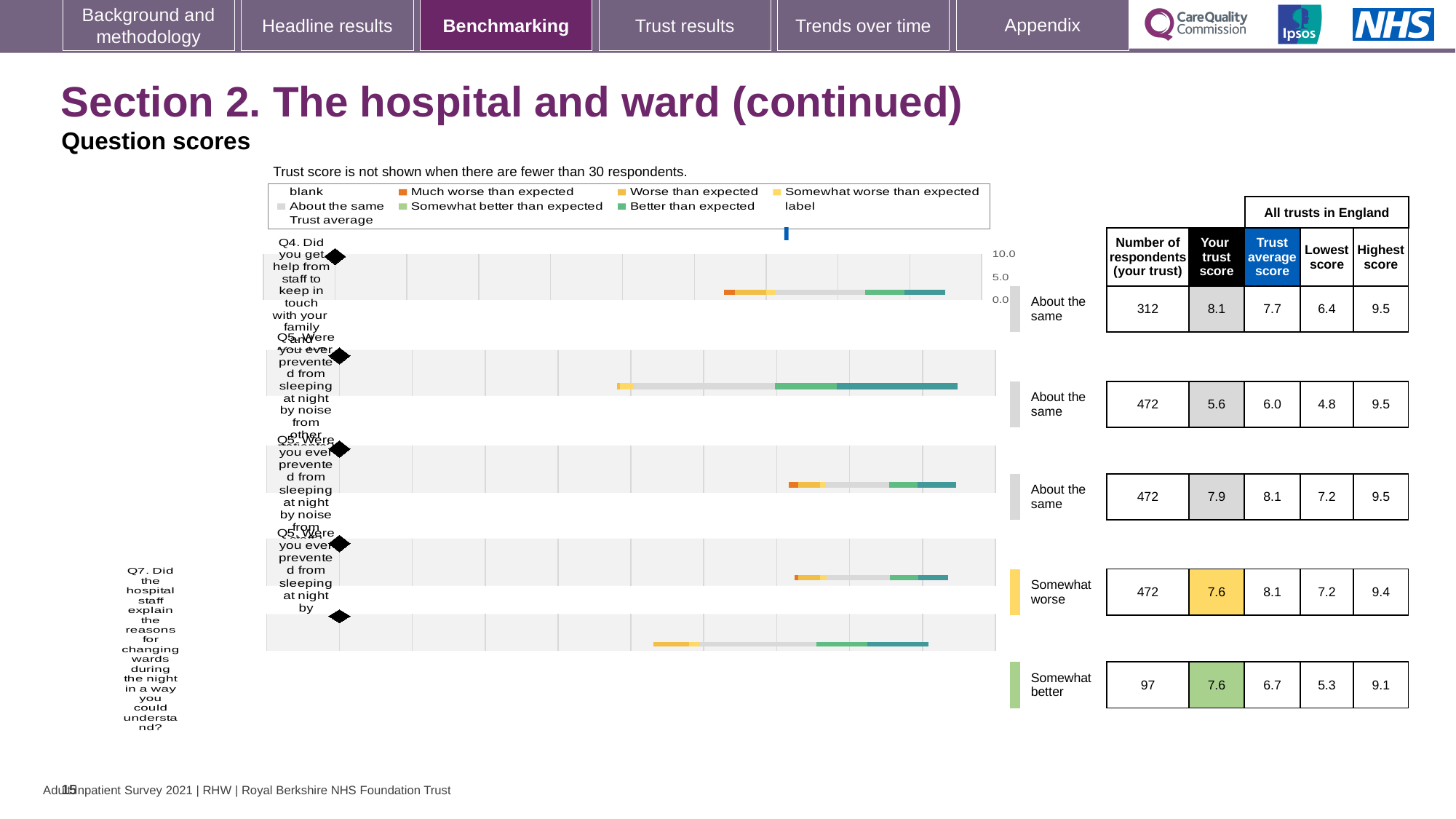
For Q7, which is larger: the trust score or the trust average score? the trust score (7.6) According to the note above the chart, below how many respondents is the trust score not shown? 30 According to the table beside the chart, what is the trust score for the last row, Q7 (explaining reasons for changing wards during the night)? 7.6 According to the table beside the chart, what is the trust score for Q4 (help from staff to keep in touch with family and friends)? 8.1 What kind of chart is shown on the slide? bar chart What benchmark category label is shown for the last row (Q7)? Somewhat better Which question row has the fewest respondents? Q7 According to the table beside the chart, what is the trust average score for Q4? 7.7 According to the table beside the chart, how many respondents answered Q7? 97 According to the table beside the chart, how many respondents answered Q4? 312 How many question rows (bars) does the chart show? 5 By how much does the Q4 trust score (8.1) exceed the trust average score (7.7)? 0.4